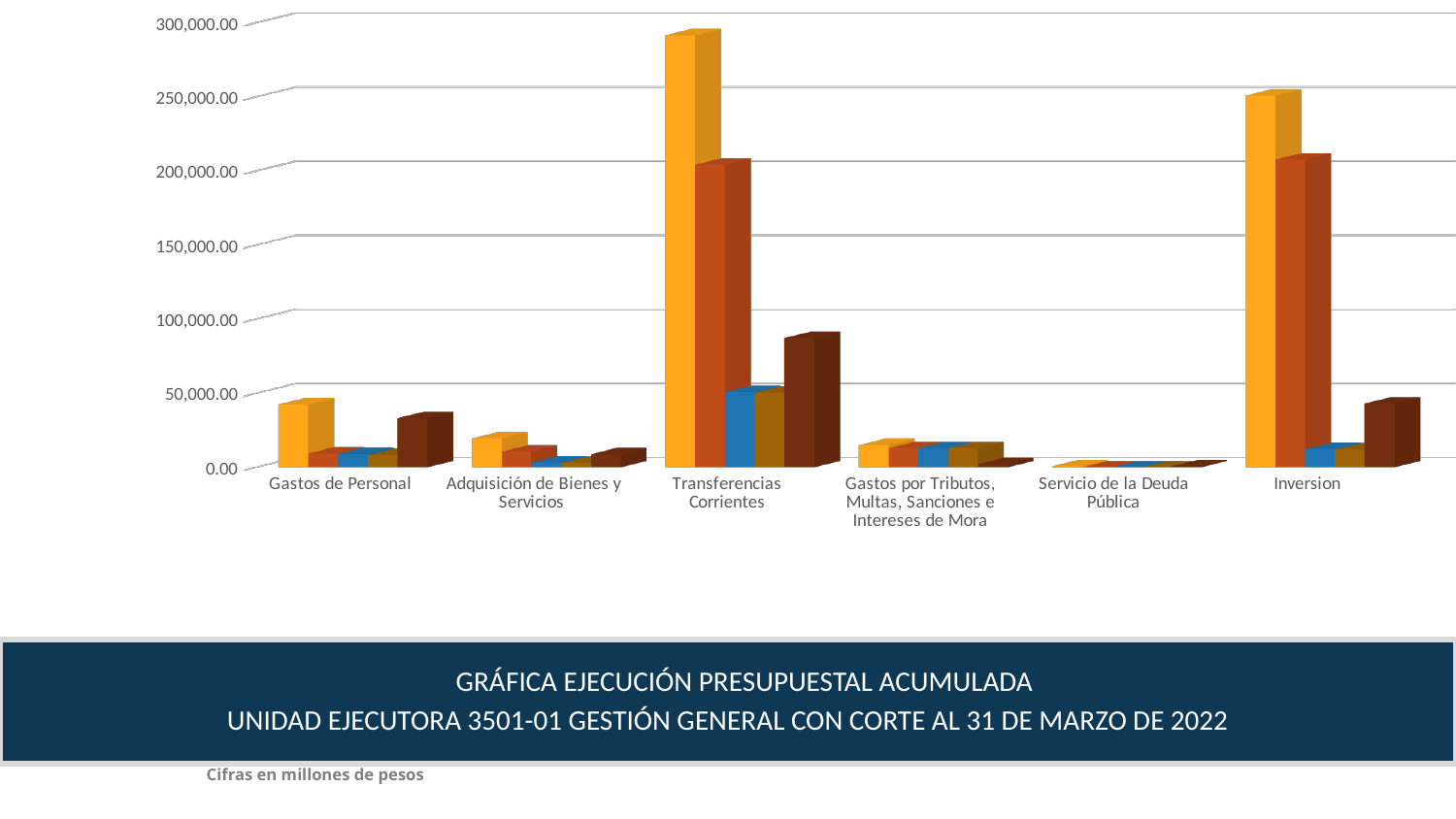
How many bars are plotted for each category in the chart? 5 How many categories are shown along the x axis of the chart? 6 According to the note below the chart, in what units are the figures expressed? Cifras en millones de pesos Which category has the lowest bars in the chart? Servicio de la Deuda Pública What kind of chart is shown on the slide? Bar chart Which category has a taller first (yellow) bar, Gastos de Personal or Adquisición de Bienes y Servicios? Gastos de Personal Which category has the tallest bar in the chart? Transferencias Corrientes Is the tallest bar for Inversion greater or less than 200,000.00? greater Which category has a taller first (yellow) bar, Transferencias Corrientes or Inversion? Transferencias Corrientes Is the tallest bar for Gastos de Personal greater or less than 50,000.00? less Is the tallest bar for Adquisición de Bienes y Servicios greater or less than 50,000.00? less